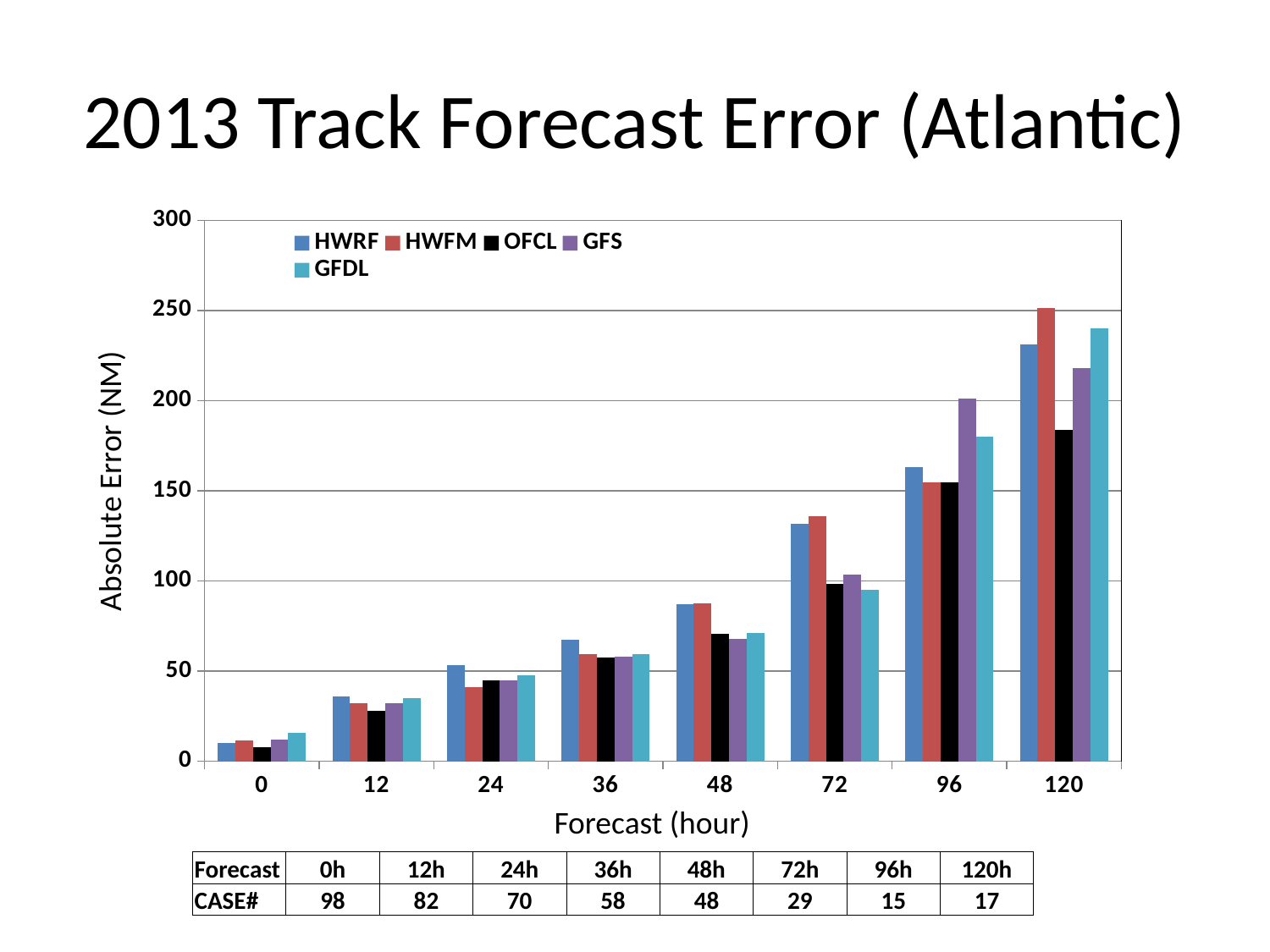
At forecast hour 120, which model has the highest absolute error? HWFM Is the HWRF absolute error at forecast hour 72 greater or less than 100? greater At forecast hour 120, which model has the lowest absolute error? OFCL Is the OFCL absolute error at forecast hour 120 greater or less than 200? less At forecast hour 96, which has the larger absolute error, GFS or OFCL? GFS How many series does the legend list? 5 What is the title of the y axis? Absolute Error (NM) Do the absolute errors generally rise or fall as the forecast hour increases? rise At forecast hour 36, which model has the highest absolute error? HWRF What kind of chart is shown on the slide? bar chart At forecast hour 96, which model has the highest absolute error? GFS How many forecast hours are shown along the x axis? 8